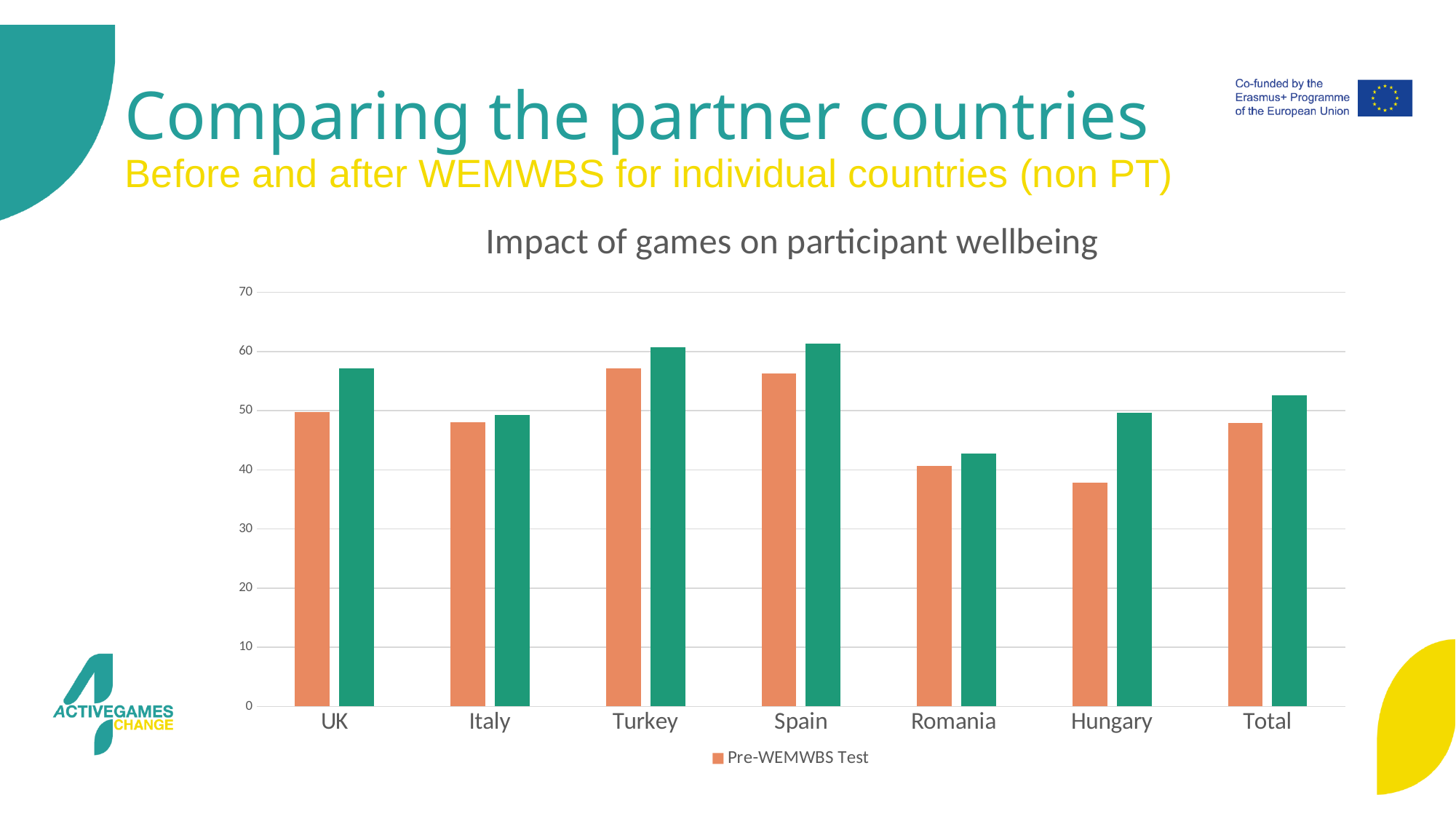
Which series is named in the chart's legend? Pre-WEMWBS Test What type of chart is shown on the slide? Bar chart Is the green bar for the UK greater or less than 50? greater Which is larger: the green bar for the UK or the green bar for Italy? UK How many series does the chart's legend list? 1 Which country has the lowest green bar? Romania Which country has the lowest orange (Pre-WEMWBS Test) bar? Hungary How many categories are shown on the x axis of the chart? 7 For Hungary, which bar is larger: the orange (Pre-WEMWBS Test) bar or the green bar? The green bar What is the title of the chart? Impact of games on participant wellbeing Is the orange (Pre-WEMWBS Test) bar for Total greater or less than 50? less Is the orange (Pre-WEMWBS Test) bar for Hungary greater or less than 40? less